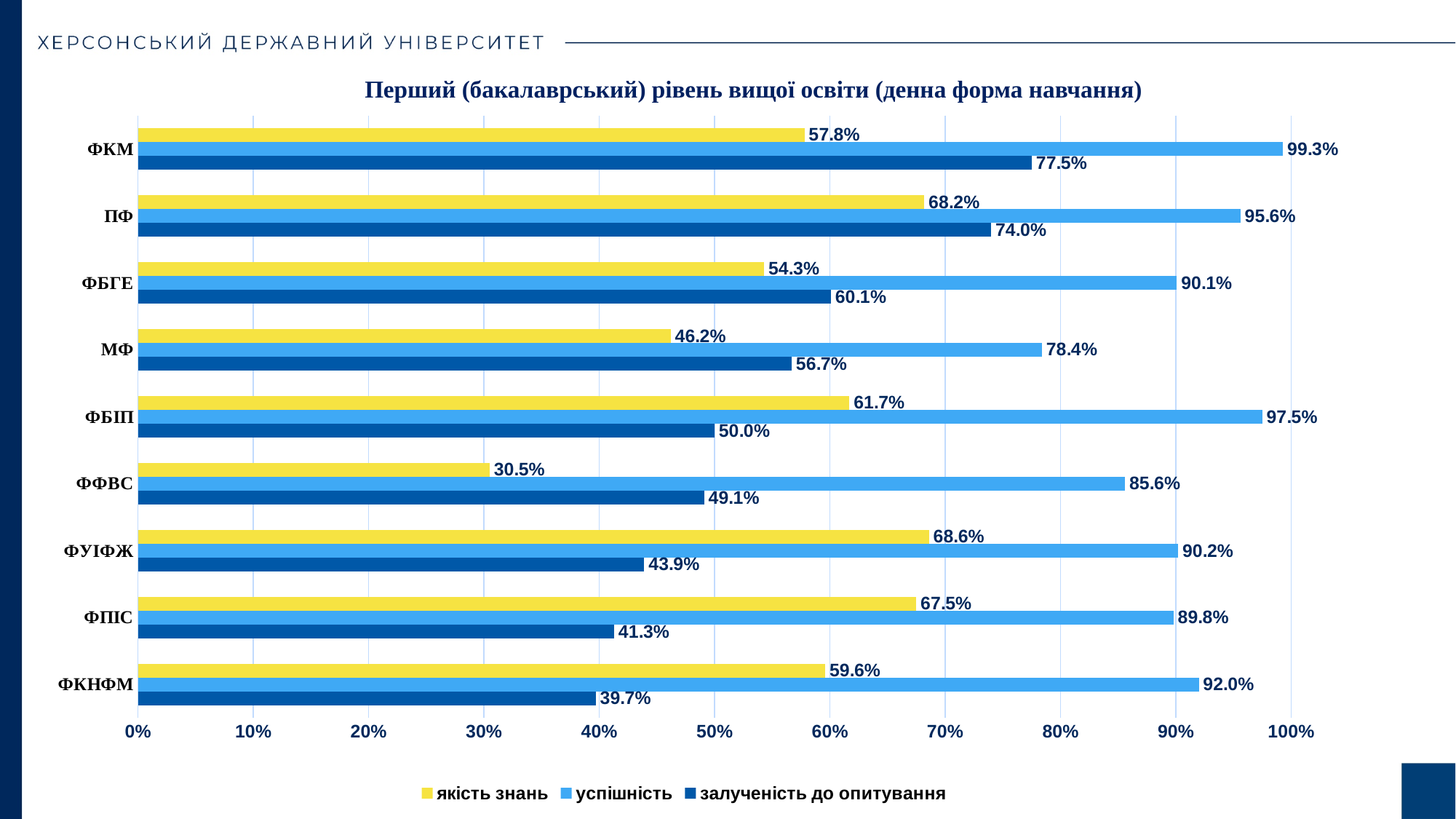
What is the успішність value for ФКМ? 99.3% What type of chart is shown on the slide? Bar chart Which is larger for ПФ: якість знань or залученість до опитування? залученість до опитування What is the difference between the успішність and якість знань values for ФБІП? 35.8 percentage points What is the якість знань value for ФФВС? 30.5% What is the залученість до опитування value for ФКНФМ? 39.7% Which faculty has the highest залученість до опитування value? ФКМ What is the title of the chart? Перший (бакалаврський) рівень вищої освіти (денна форма навчання) How many faculties are shown on the chart? 9 Which faculty has the lowest якість знань value? ФФВС Which faculty has the lowest успішність value? МФ How many series does the legend list? 3